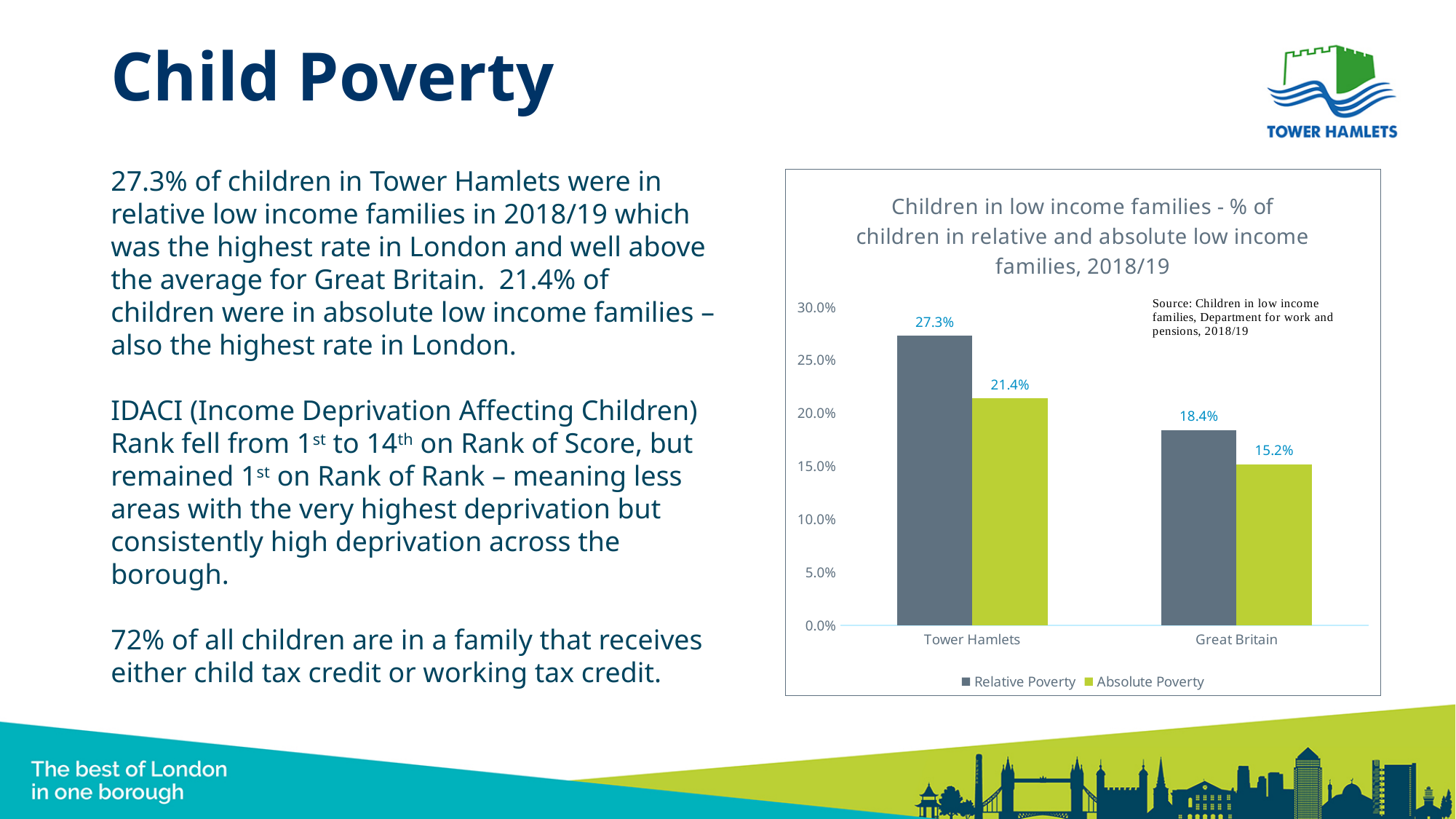
What is the Relative Poverty value for Great Britain? 18.4% What kind of chart is shown on the slide? Bar chart Which category has the lowest Absolute Poverty value? Great Britain What is the difference between the Relative Poverty values for Tower Hamlets and Great Britain? 8.9% Which category has the highest Relative Poverty value? Tower Hamlets What is the Absolute Poverty value for Tower Hamlets? 21.4% What is the difference between the Relative Poverty and Absolute Poverty values for Tower Hamlets? 5.9% How many categories are shown on the x axis of the chart? 2 What is the Relative Poverty value for Tower Hamlets? 27.3% How many series does the chart legend list? 2 Which is larger: the Absolute Poverty value for Tower Hamlets or the Relative Poverty value for Great Britain? Absolute Poverty for Tower Hamlets What is the Absolute Poverty value for Great Britain? 15.2%